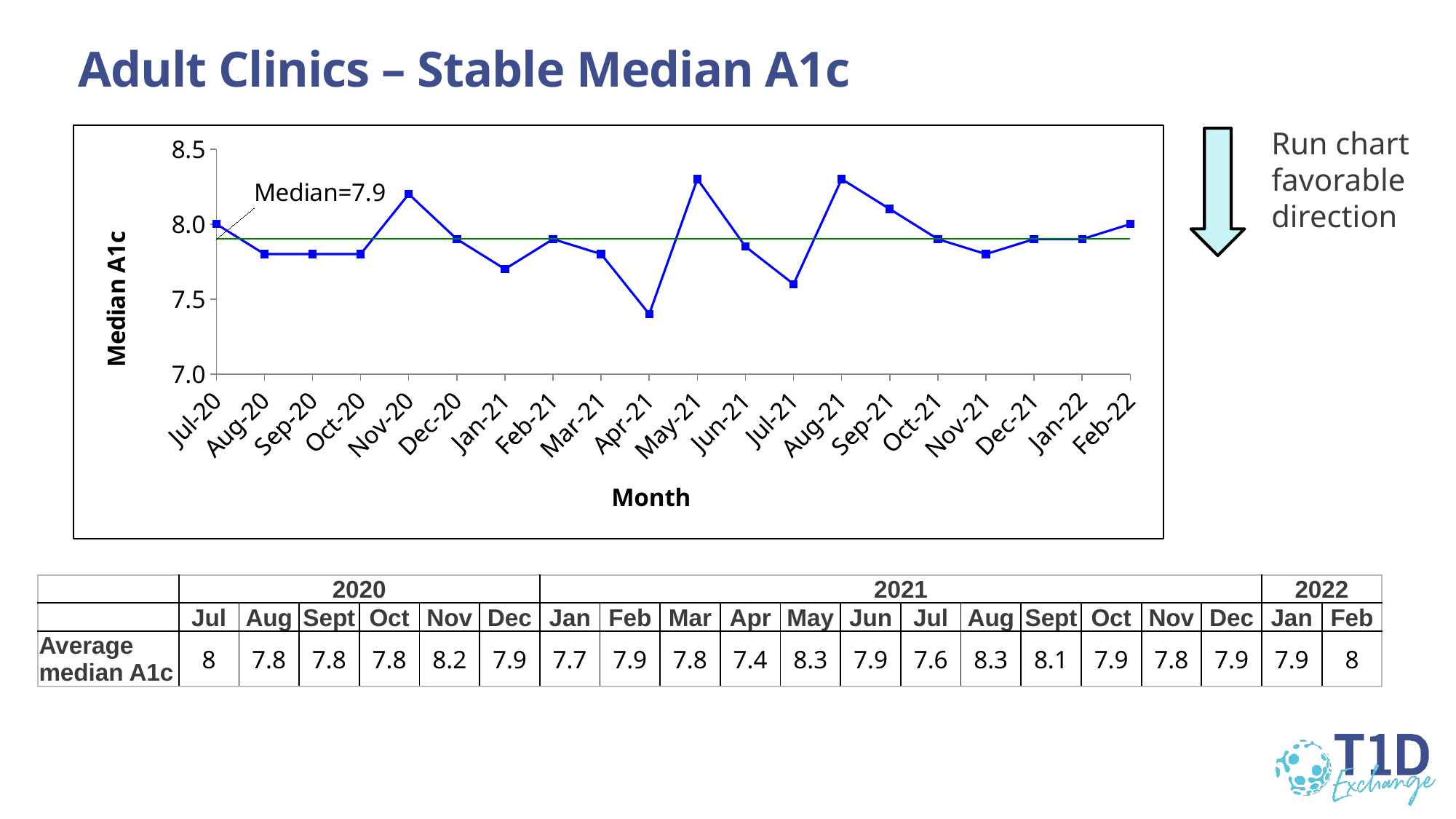
What is the median A1c value for Feb-22? 8 Is the value for Apr-21 greater or less than 7.5? less What is the difference between the median A1c for May-21 and Jul-21? 0.7 What kind of chart is shown on the slide? line chart How many months are plotted on the chart? 20 What is the median A1c value for Nov-20? 8.2 Which is larger, the median A1c for Sep-21 or for Nov-21? Sep-21 What is the highest median A1c value plotted on the chart? 8.3 Which month has the lowest median A1c? Apr-21 What is the median A1c value for Apr-21? 7.4 What median value is marked by the horizontal reference line on the chart? 7.9 What is the difference between the median A1c for Nov-20 and Apr-21? 0.8